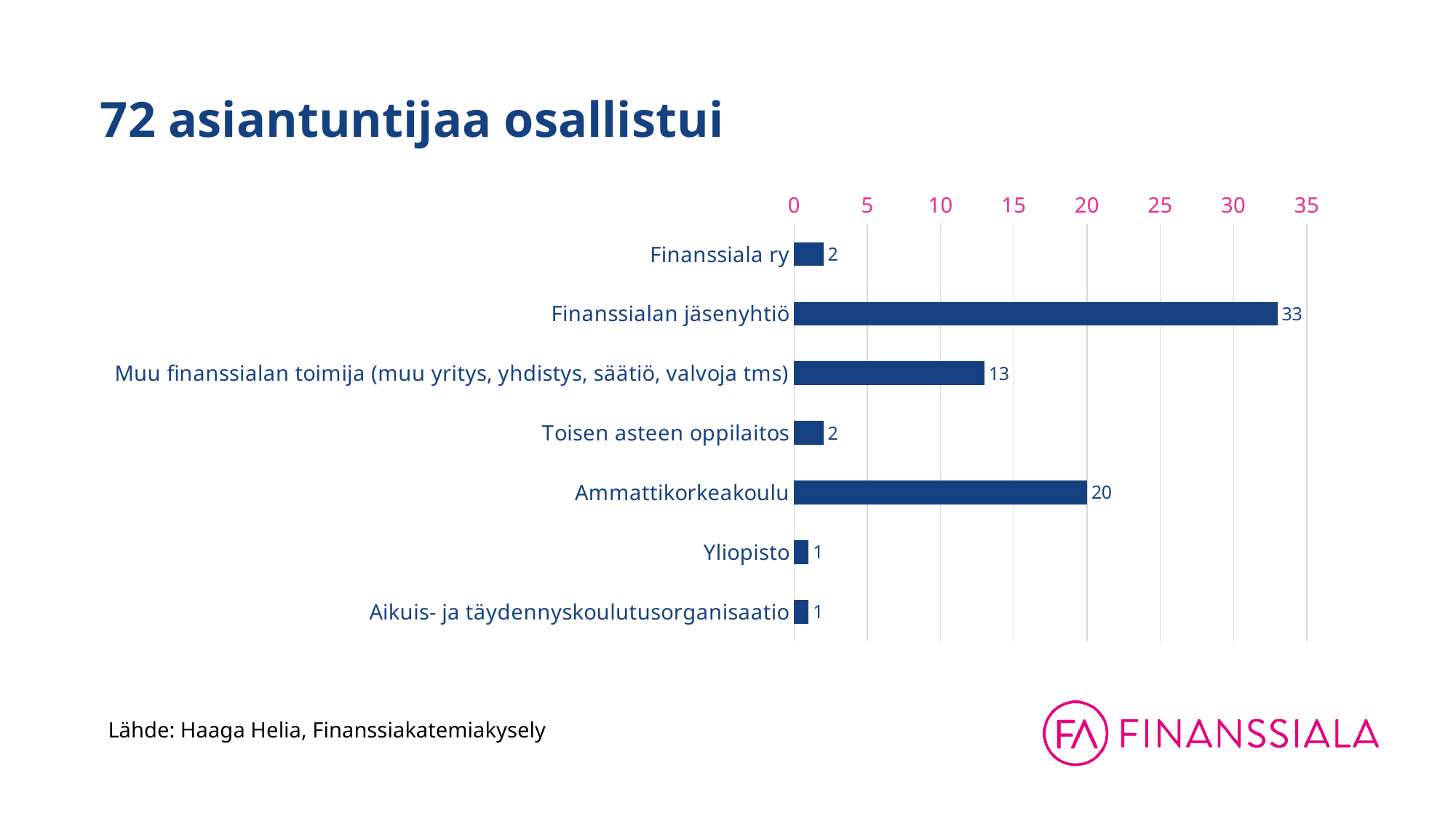
What kind of chart is shown on the slide? bar chart What is the value for Muu finanssialan toimija (muu yritys, yhdistys, säätiö, valvoja tms)? 13 What is the difference between the values for Finanssialan jäsenyhtiö and Ammattikorkeakoulu? 13 What is the value for Yliopisto? 1 Which is larger, the value for Ammattikorkeakoulu or the value for Muu finanssialan toimija? Ammattikorkeakoulu Is the value for Finanssialan jäsenyhtiö greater or less than 30? greater What is the title of the slide? 72 asiantuntijaa osallistui What is the source cited below the chart? Haaga Helia, Finanssiakatemiakysely Which category has the highest value? Finanssialan jäsenyhtiö What is the value for Finanssialan jäsenyhtiö? 33 How many categories are shown in the chart? 7 What is the value for Ammattikorkeakoulu? 20